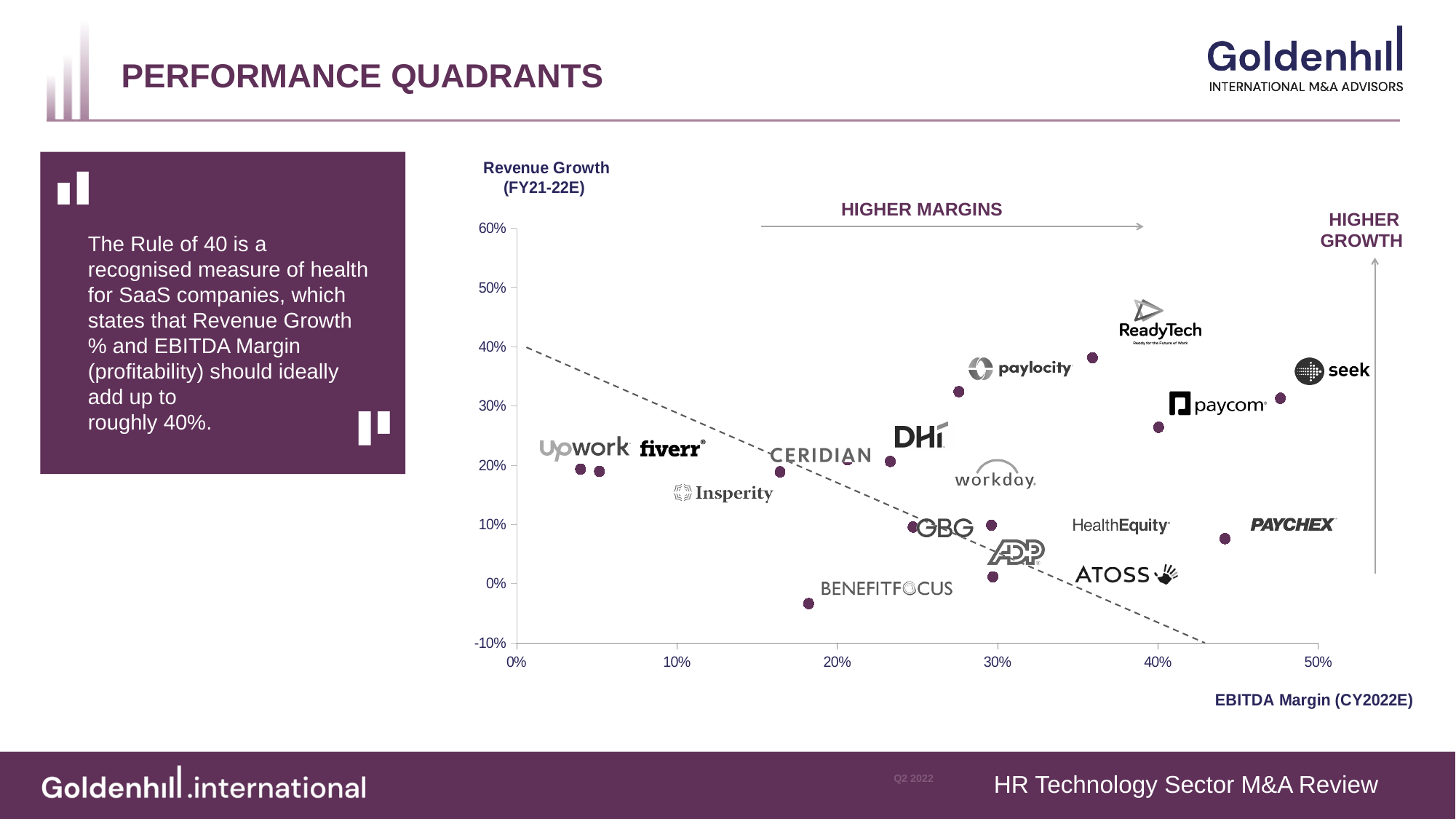
Is the revenue growth for ReadyTech greater or less than 30%? greater Which company has the lowest revenue growth on the chart? Benefitfocus What is the title of the horizontal axis of the chart? EBITDA Margin (CY2022E) Is the EBITDA margin for Upwork greater or less than 10%? less Is the revenue growth for Benefitfocus greater or less than 0%? less What kind of chart is shown on the slide? Scatter chart Which has the higher revenue growth, ReadyTech or Paycom? ReadyTech Which company has the highest EBITDA margin on the chart? Seek Which company has the highest revenue growth on the chart? ReadyTech What is the title of the vertical axis of the chart? Revenue Growth (FY21-22E) Which has the higher EBITDA margin, Seek or Paycom? Seek